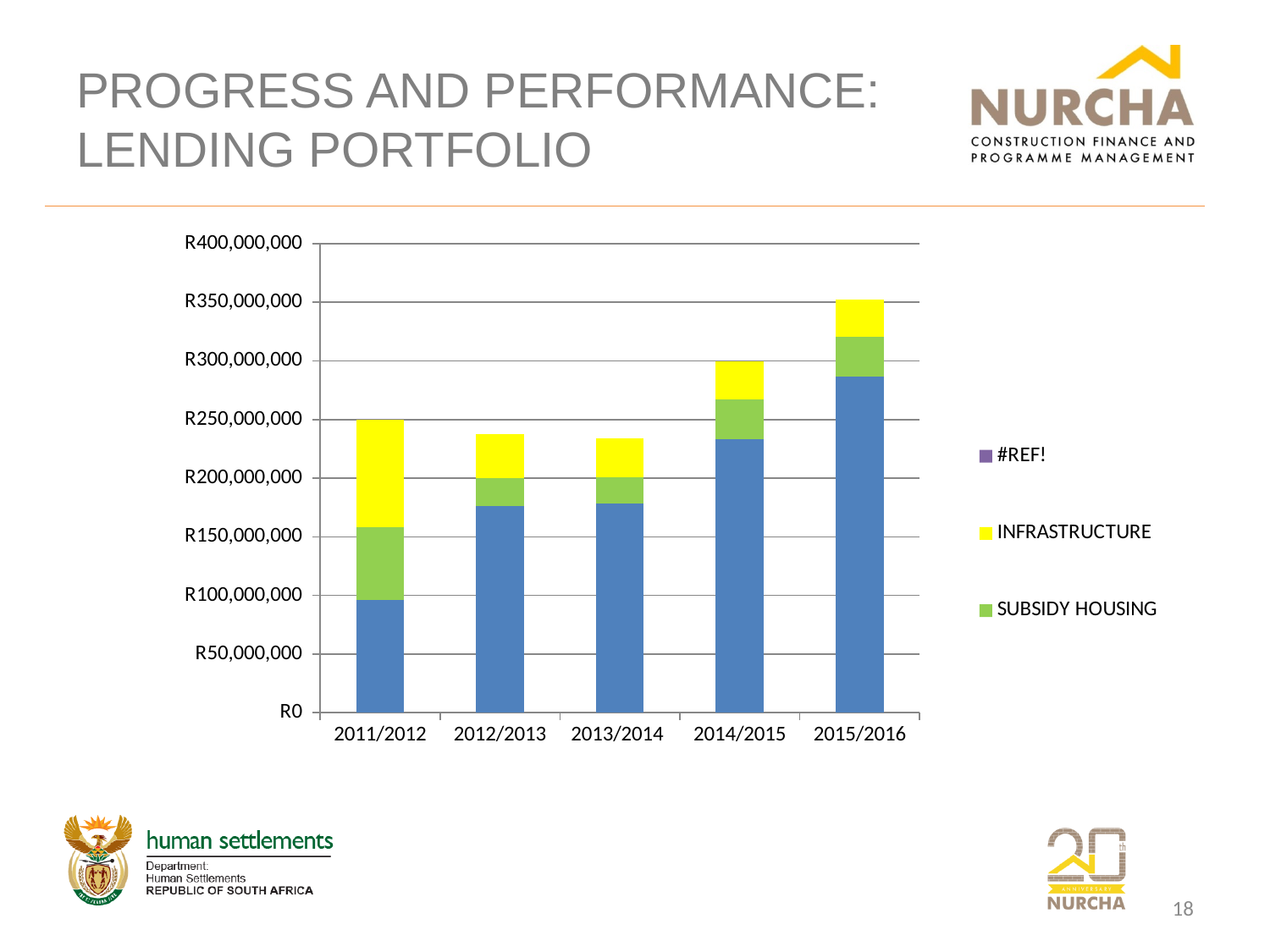
How many financial years are shown on the x axis of the chart? 5 Which total stacked bar is larger, 2011/2012 or 2012/2013? 2011/2012 Which financial year has the largest INFRASTRUCTURE (yellow) segment? 2011/2012 How many series does the chart's legend list? 3 Which financial year has the highest total stacked bar? 2015/2016 What colour represents INFRASTRUCTURE in the chart? Yellow What kind of chart is shown on the slide? Stacked bar chart Is the total stacked bar for 2015/2016 greater or less than R300,000,000? greater Is the total stacked bar for 2011/2012 greater or less than R200,000,000? greater